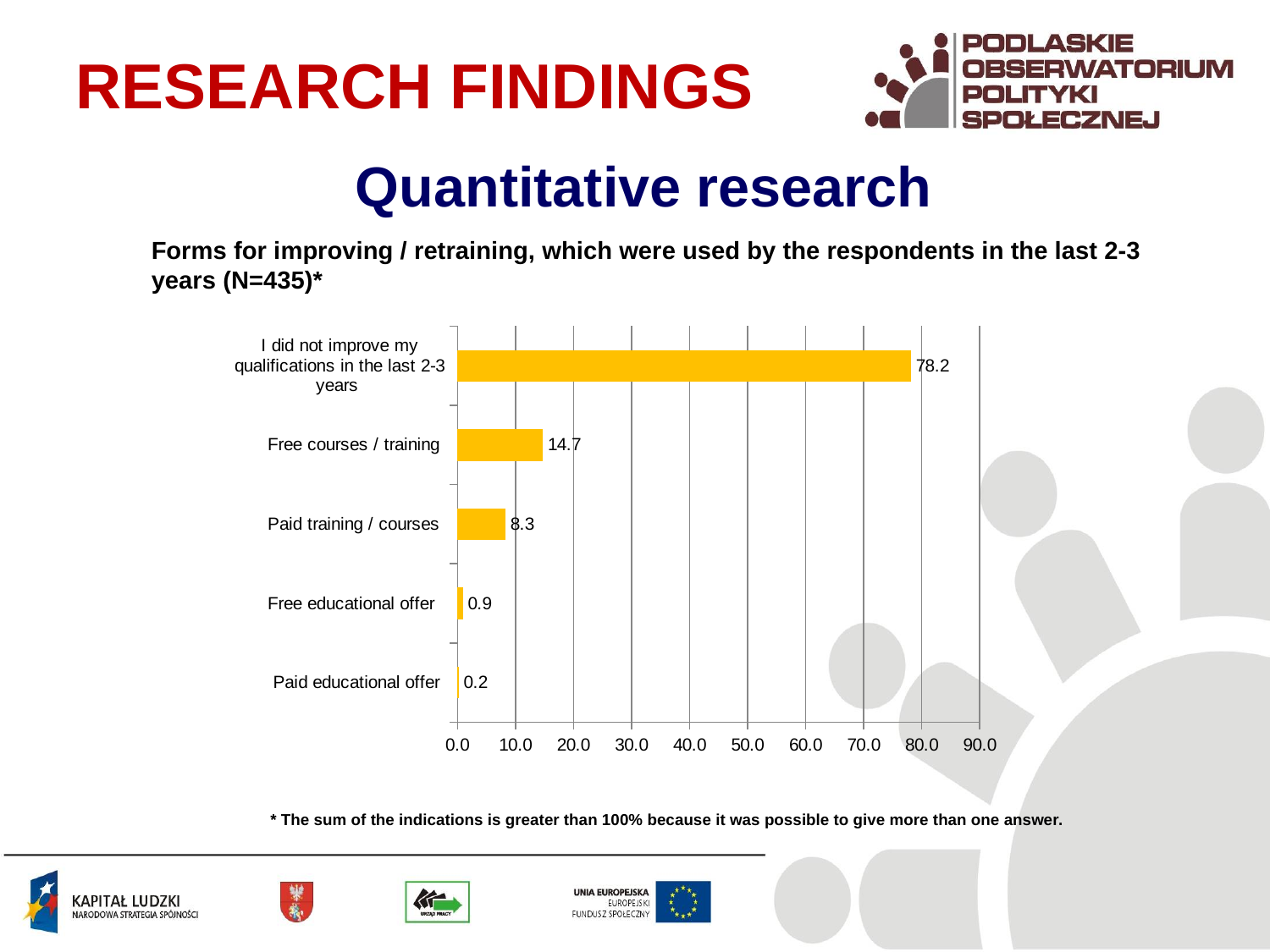
Which is larger: the value for "Free educational offer" or "Paid educational offer"? Free educational offer Is the value for "I did not improve my qualifications in the last 2-3 years" greater or less than 70.0? greater What is the highest tick value shown on the horizontal axis? 90.0 What kind of chart is shown on the slide? Bar chart What is the difference between the values for "Free courses / training" and "Paid training / courses"? 6.4 What is the value for "Free educational offer"? 0.9 What is the value for "Paid training / courses"? 8.3 What is the value for "Paid educational offer"? 0.2 What is the value for "Free courses / training"? 14.7 Which category has the lowest value? Paid educational offer Which category has the highest value? I did not improve my qualifications in the last 2-3 years How many categories are shown in the chart? 5